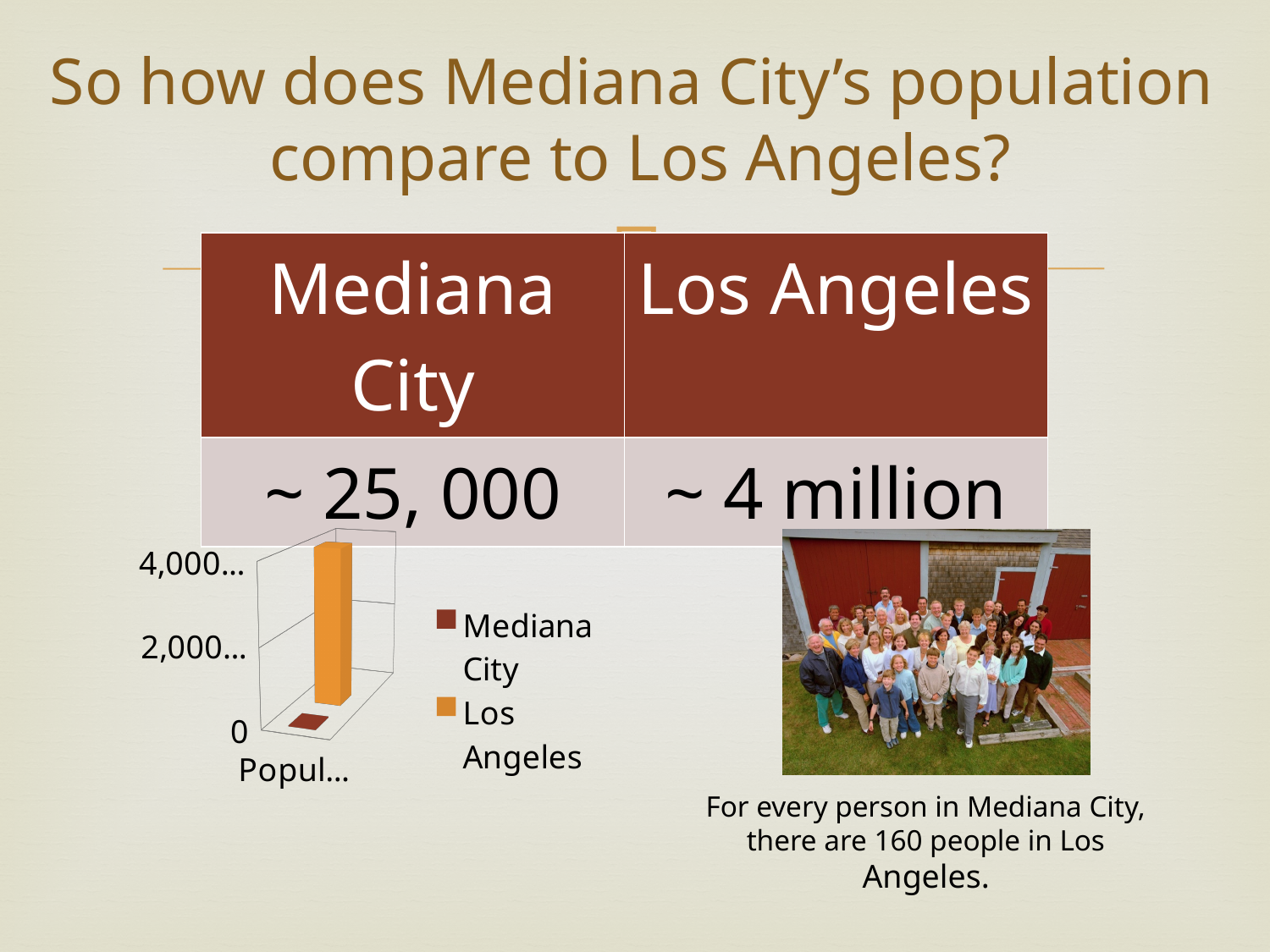
What colour is the Los Angeles series in the chart's legend? orange How many bars are plotted in the chart? 2 Which bar is taller in the chart, Mediana City or Los Angeles? Los Angeles What kind of chart is shown on the slide? bar chart Which series has the tallest bar in the chart? Los Angeles How many series does the chart's legend list? 2 What is the lowest value shown on the chart's vertical axis? 0 Which series has the shortest bar in the chart? Mediana City